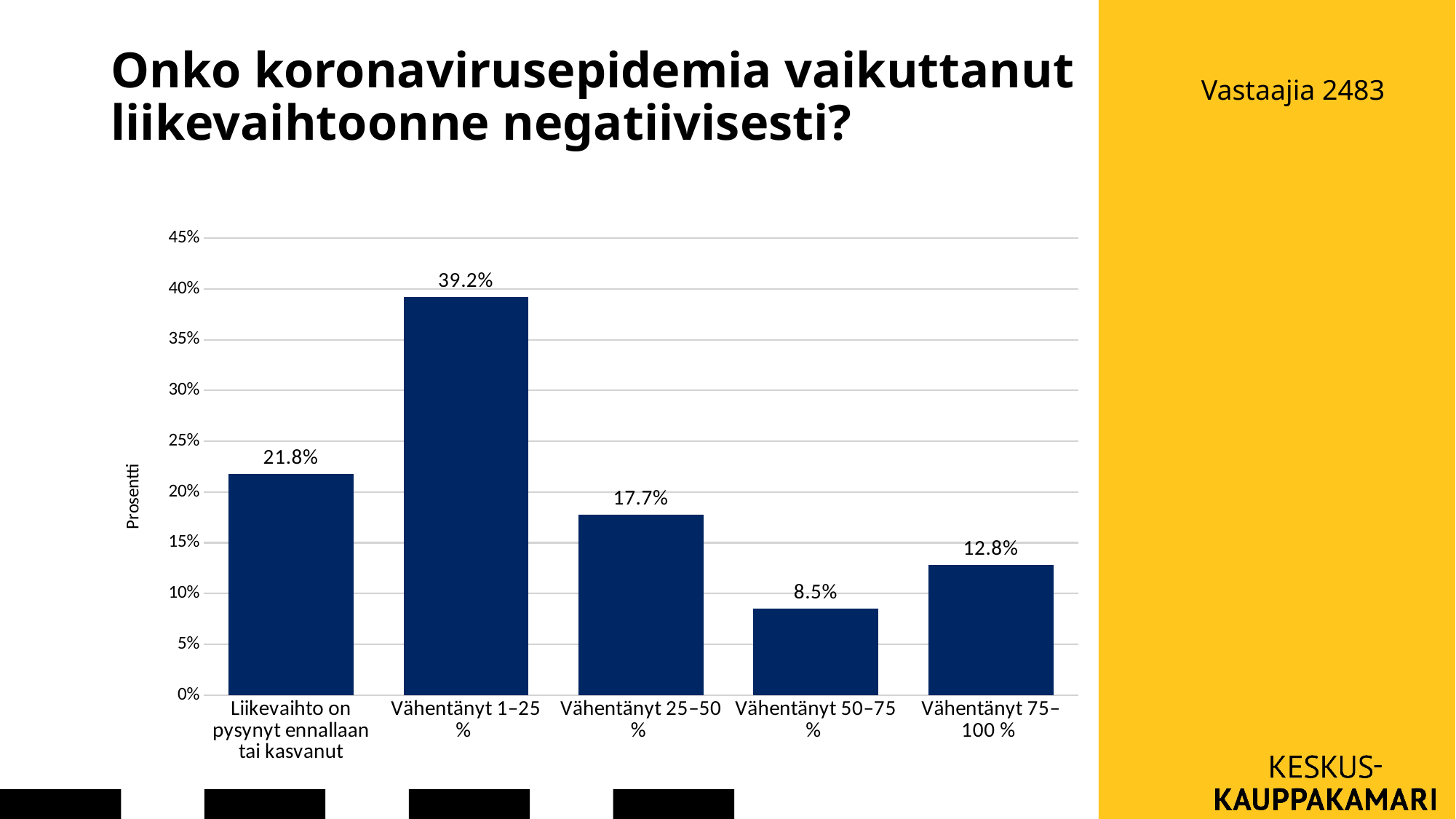
Which category has the lowest value? Vähentänyt 50–75 % Which category has the highest value? Vähentänyt 1–25 % What is the value for "Liikevaihto on pysynyt ennallaan tai kasvanut"? 21.8% What is the value for "Vähentänyt 75–100 %"? 12.8% Which is larger: the value for "Vähentänyt 25–50 %" or "Vähentänyt 75–100 %"? Vähentänyt 25–50 % How many categories are shown on the chart? 5 What is the value for "Vähentänyt 1–25 %"? 39.2% What kind of chart is shown on the slide? Bar chart What is the difference between the values for "Vähentänyt 1–25 %" and "Vähentänyt 25–50 %"? 21.5% What is the label of the vertical axis? Prosentti What is the value for "Vähentänyt 50–75 %"? 8.5% Is the value for "Liikevaihto on pysynyt ennallaan tai kasvanut" greater or less than 20%? greater